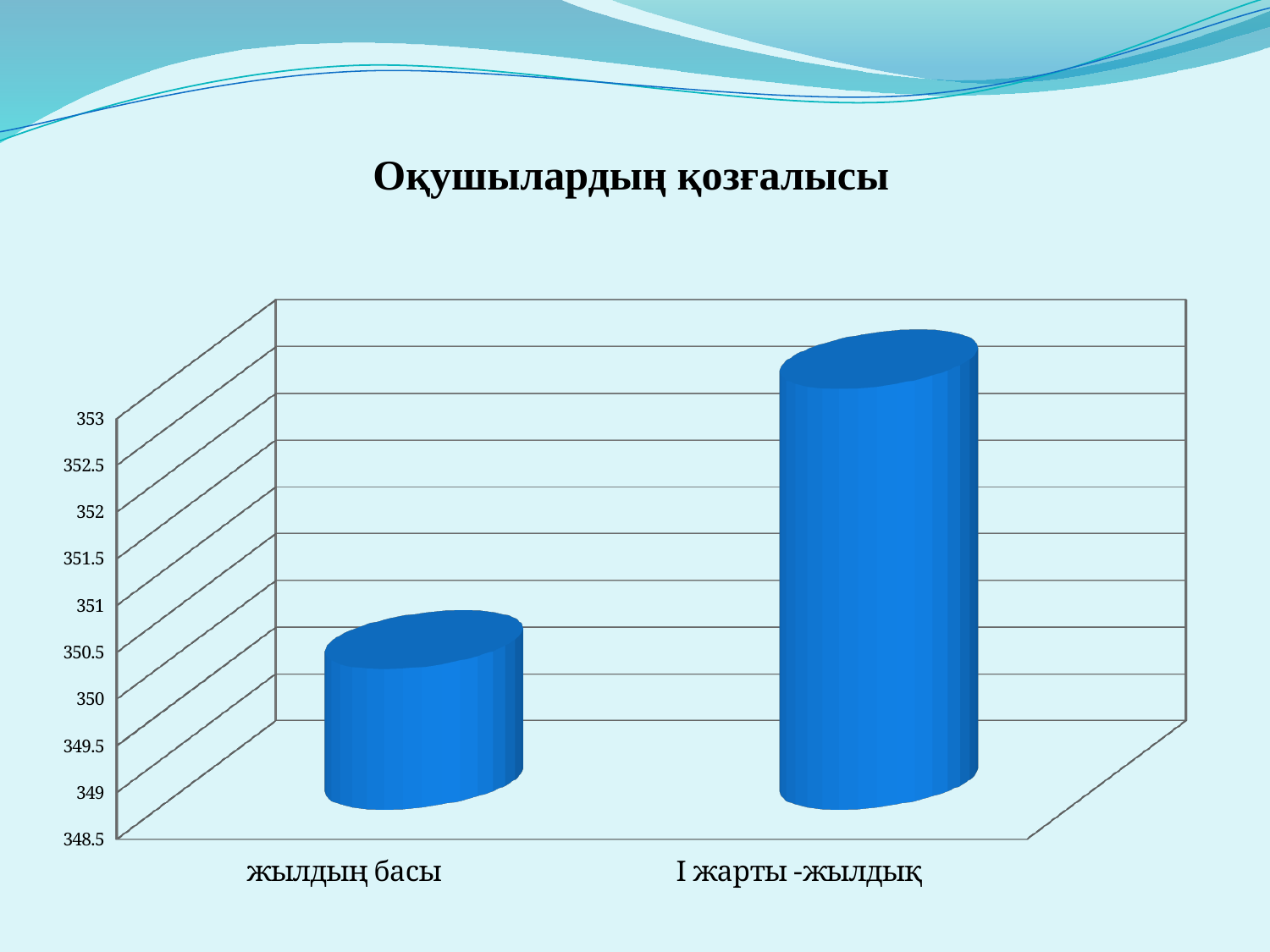
Which category has the lowest value? жылдың басы What kind of chart is shown on the slide? bar chart How many categories are plotted on the chart? 2 What is the lowest value shown on the vertical axis? 348.5 Is the value for I жарты -жылдық greater or less than 351? greater Is the value for жылдың басы greater or less than 351? less Which is larger, the value for жылдың басы or the value for I жарты -жылдық? I жарты -жылдық Which category has the highest value? I жарты -жылдық Is the value for I жарты -жылдық greater or less than 350? greater Do the values rise or fall from жылдың басы to I жарты -жылдық? rise What is the title of the chart? Оқушылардың қозғалысы